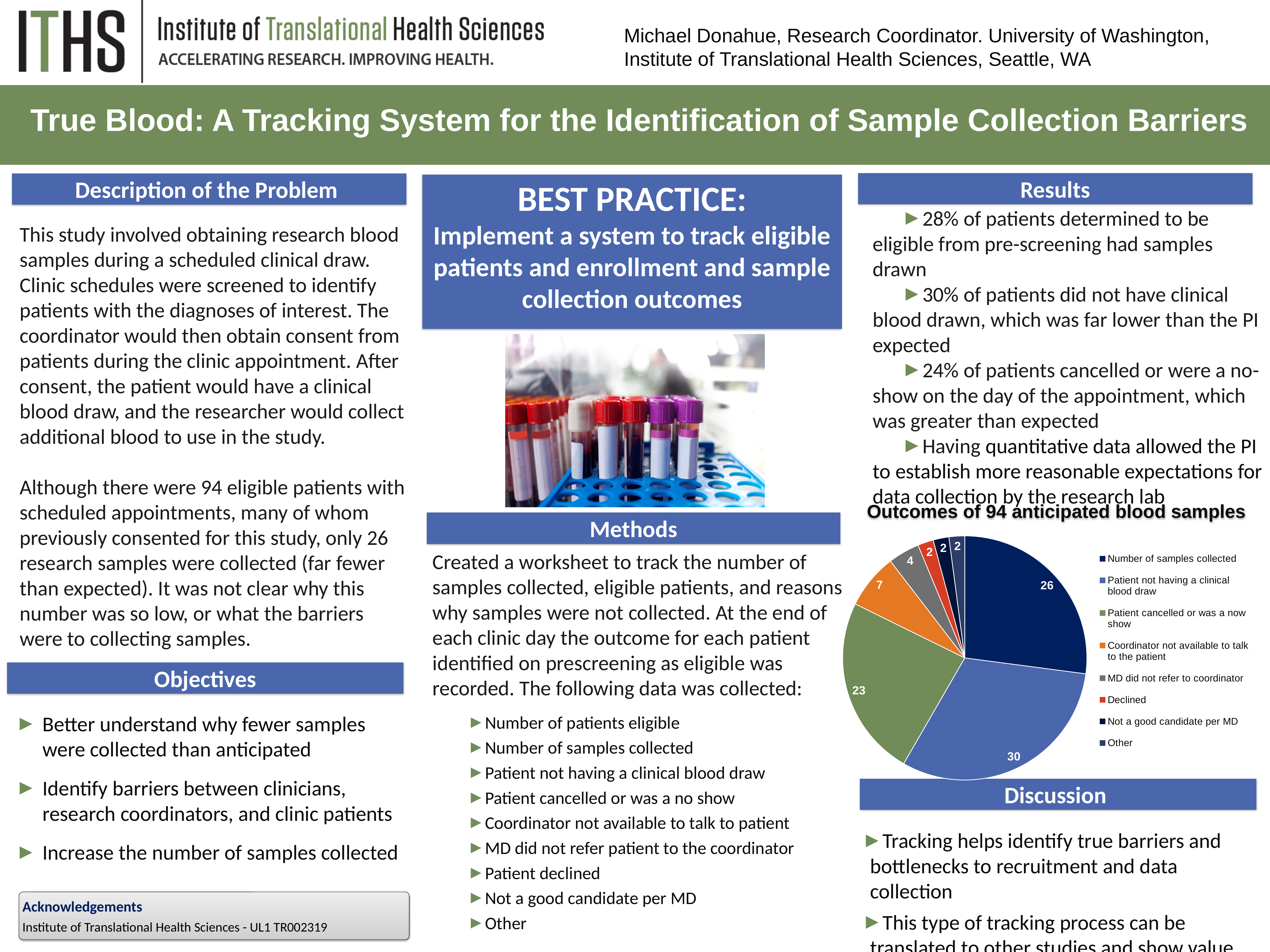
In the pie chart, what is the value for "Number of samples collected"? 26 In the pie chart, what is the value for "MD did not refer to coordinator"? 4 Which category has the largest slice in the pie chart? Patient not having a clinical blood draw In the pie chart, what is the value for "Patient not having a clinical blood draw"? 30 In the pie chart, which is larger: "Number of samples collected" or "Patient cancelled or was a now show"? Number of samples collected In the pie chart, what is the value for "Coordinator not available to talk to the patient"? 7 In the pie chart, what is the value for "Patient cancelled or was a now show"? 23 What is the title of the pie chart? Outcomes of 94 anticipated blood samples How many categories does the legend of the pie chart list? 8 In the pie chart, what is the difference between "Patient not having a clinical blood draw" and "Number of samples collected"? 4 In the pie chart, what is the value for "Declined"? 2 What kind of chart is shown under the title "Outcomes of 94 anticipated blood samples"? pie chart